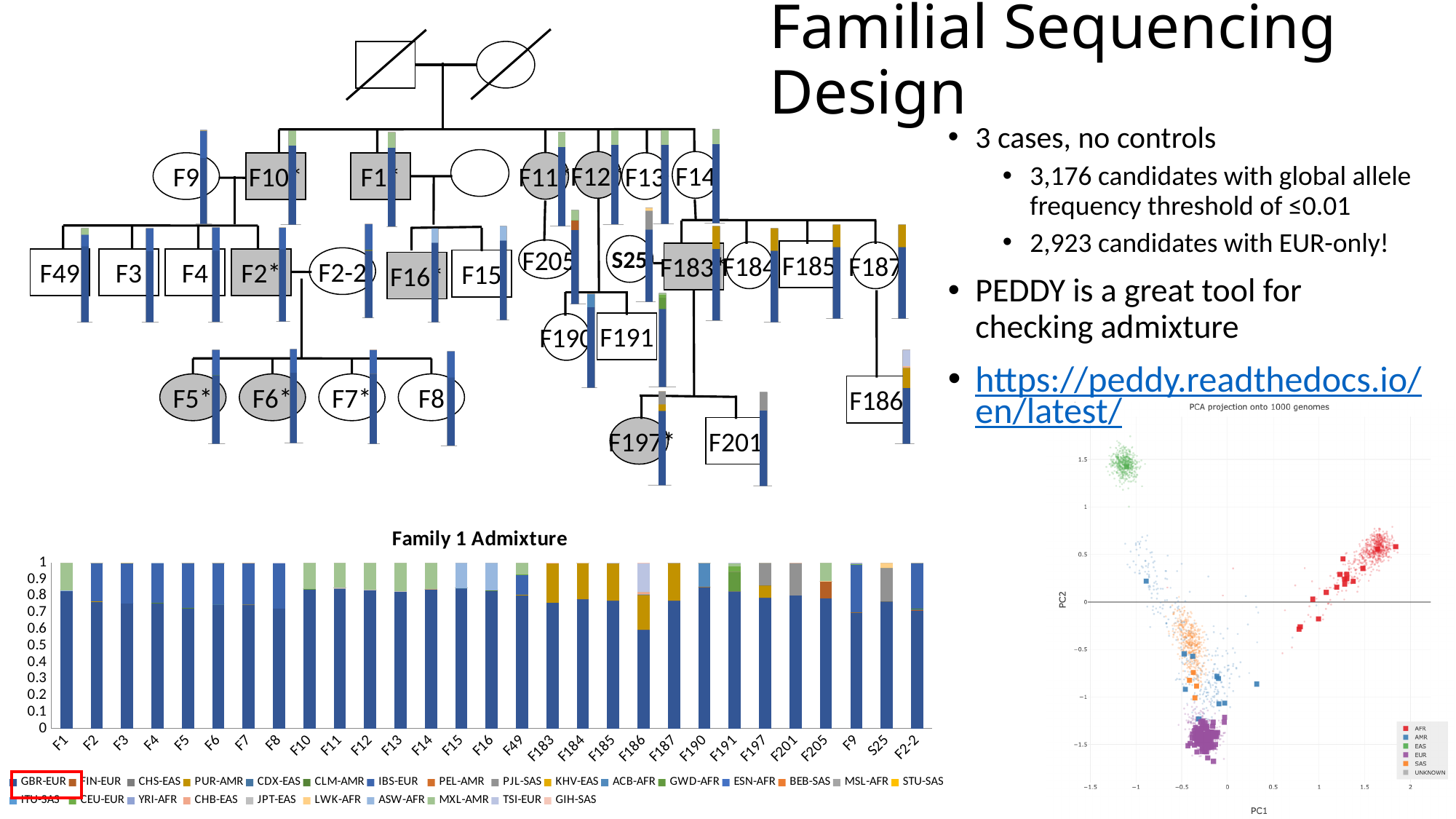
How many categories are shown on the x axis of the "Family 1 Admixture" chart? 29 What kind of chart is the "Family 1 Admixture" chart? stacked bar chart How many entries does the legend of the "PCA projection onto 1000 genomes" chart list? 6 In the "Family 1 Admixture" chart, is the GBR-EUR value for F186 greater or less than 0.7? less What kind of chart is the "PCA projection onto 1000 genomes" chart? scatter plot In the "Family 1 Admixture" chart, which has the larger GBR-EUR portion, F1 or F186? F1 In the "Family 1 Admixture" chart, which category has the smallest GBR-EUR (blue) portion? F186 How many series does the legend of the "Family 1 Admixture" chart list? 26 In the "Family 1 Admixture" chart, is the GBR-EUR value for F2 greater or less than 0.6? greater In the "Family 1 Admixture" chart, is the GBR-EUR value for F9 greater or less than 0.8? less In the "Family 1 Admixture" chart, what is the total height of the stacked bar for F1? 1